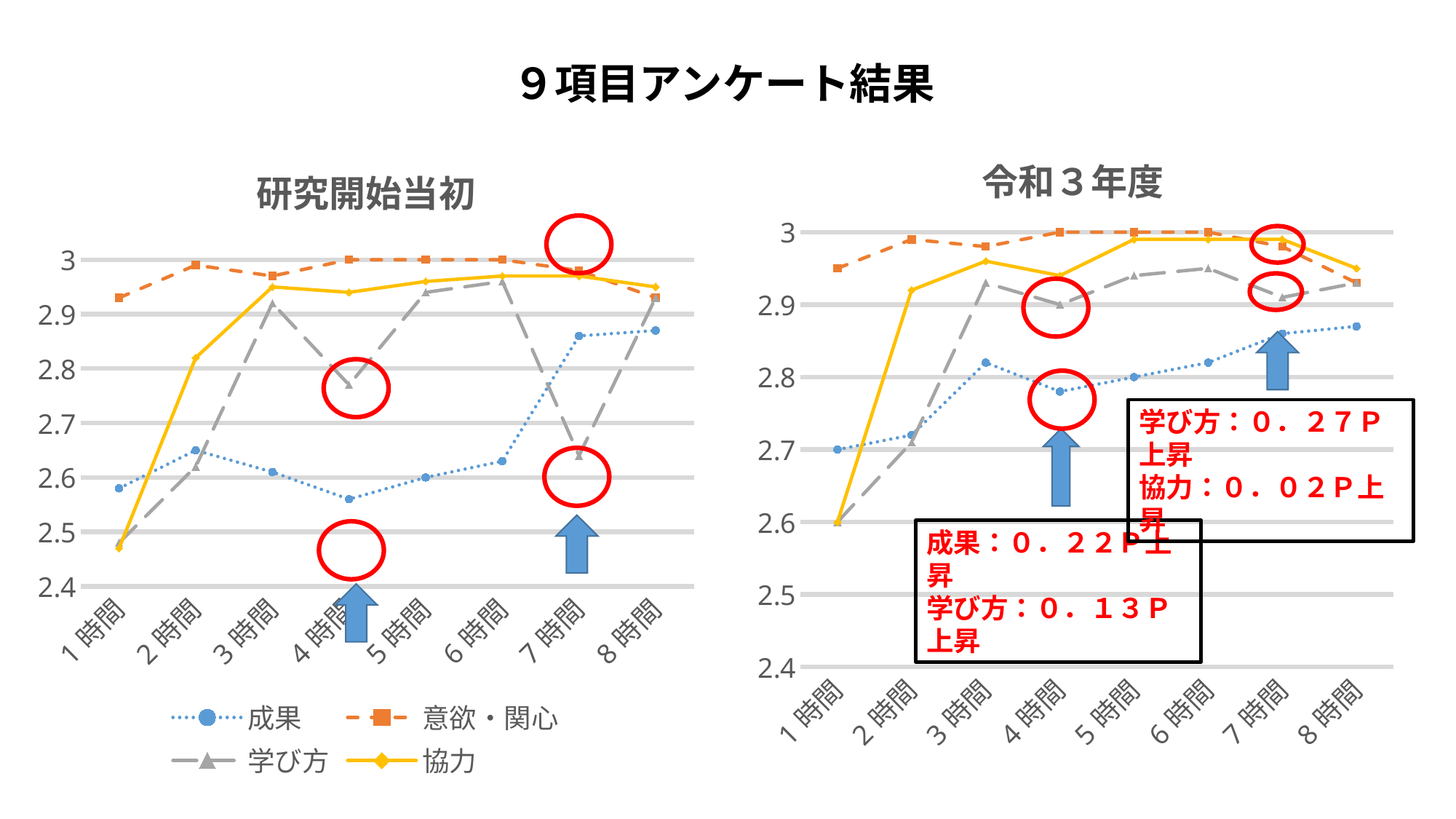
In the left chart titled 研究開始当初, is the value for 成果 at 4時間 greater or less than 2.6? less In the right chart titled 令和３年度, what is the value of 意欲・関心 at 5時間? 3 In the right chart titled 令和３年度, does the 成果 series generally rise or fall from 1時間 to 8時間? rise What type of chart is the left chart titled 研究開始当初? line chart How many series does the legend list? 4 In the left chart titled 研究開始当初, which series has the highest value at 1時間? 意欲・関心 In the left chart titled 研究開始当初, is the value for 学び方 at 4時間 greater or less than 2.8? less In the right chart titled 令和３年度, which series has the lowest value at 4時間? 成果 In the left chart titled 研究開始当初, which is larger at 4時間: 学び方 or 成果? 学び方 In the right chart titled 令和３年度, what is the value of 学び方 at 4時間? 2.9 In the right chart titled 令和３年度, how many categories are on the x axis? 8 In the right chart titled 令和３年度, what is the value of 成果 at 1時間? 2.7